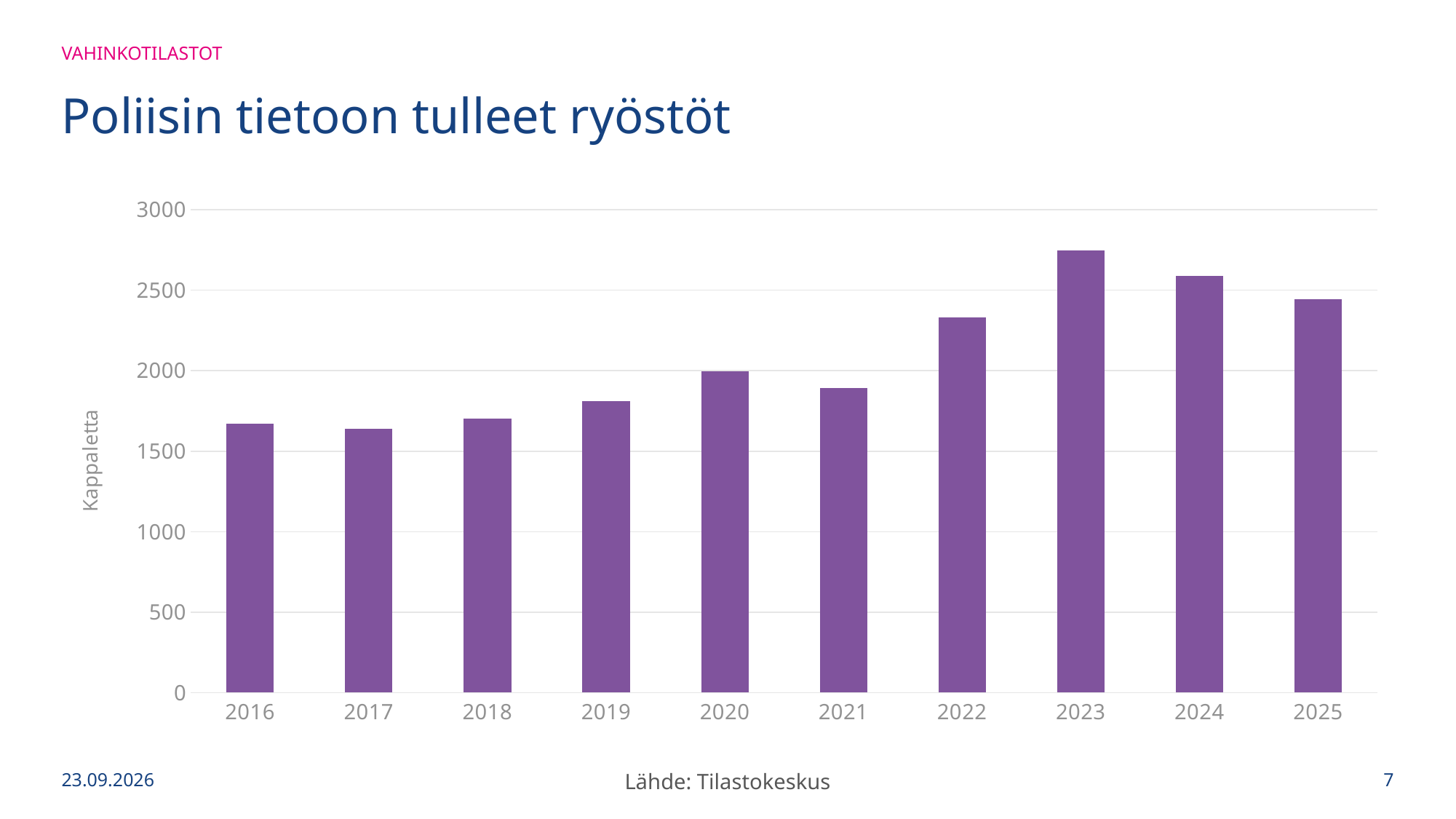
Which year has the larger value, 2024 or 2025? 2024 Which year has the larger value, 2019 or 2022? 2022 Is the value for 2023 greater or less than 2500? greater Is the value for 2025 greater or less than 2500? less Is the value for 2022 greater or less than 2000? greater What is the label on the vertical axis of the chart? Kappaletta Which year has the highest number of robberies in the chart? 2023 Do the values generally rise or fall from 2016 to 2023? rise What kind of chart is shown on the slide? bar chart How many years are shown on the x axis of the chart? 10